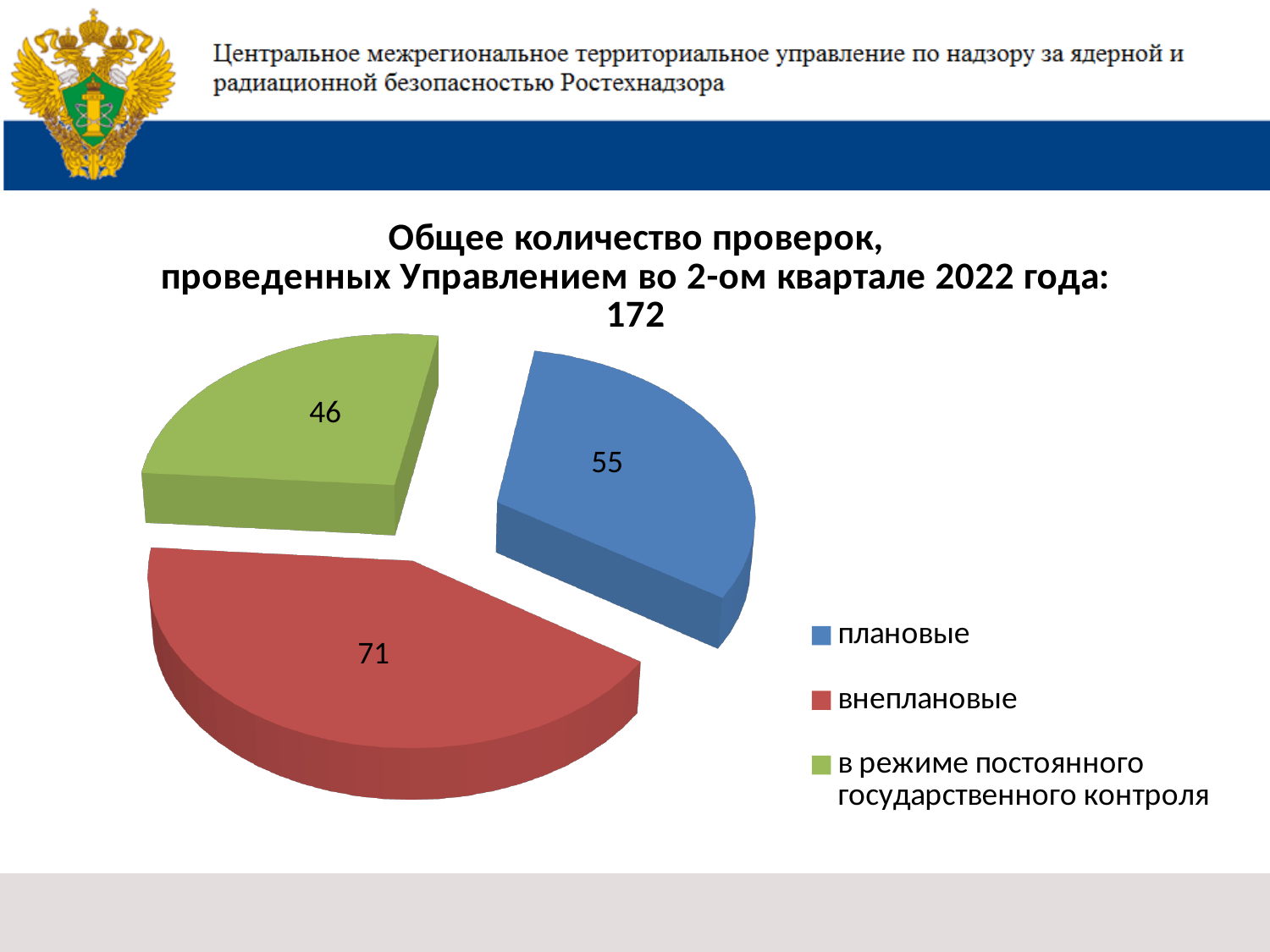
What is the difference between the values for плановые and в режиме постоянного государственного контроля? 9 How many slices does the pie chart have? 3 What is the value for в режиме постоянного государственного контроля? 46 What kind of chart is shown on the slide? pie chart What is the value for внеплановые? 71 What is the total number of inspections shown in the chart title? 172 What is the difference between the values for внеплановые and плановые? 16 What colour is the slice for внеплановые? red Which category has the largest slice of the pie? внеплановые Which category has the smallest slice of the pie? в режиме постоянного государственного контроля Which is larger, плановые or внеплановые? внеплановые What is the value for плановые? 55